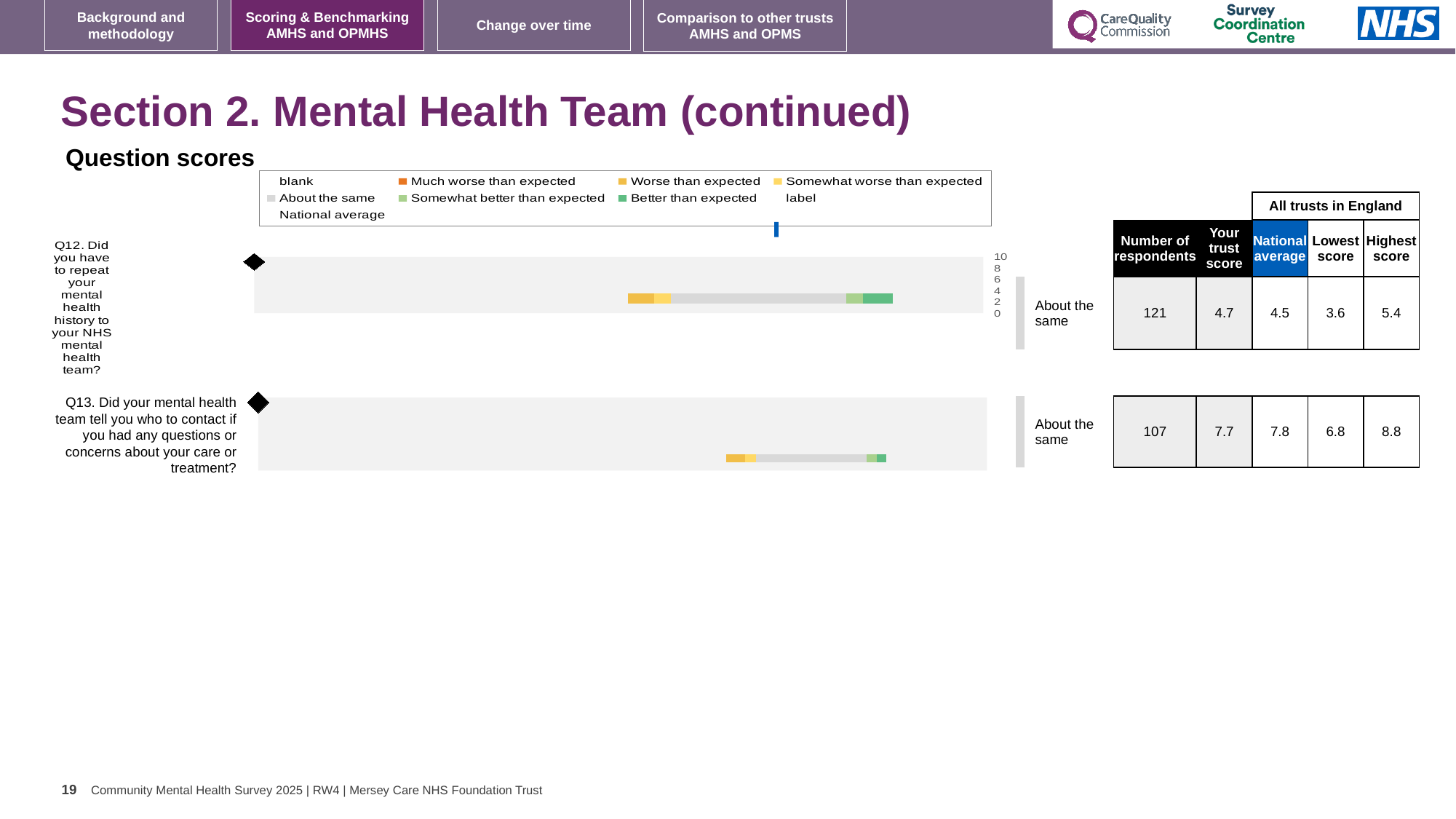
What is the 'Your trust score' value for Q13 (told who to contact with questions or concerns)? 7.7 What is the 'Your trust score' value for Q12 (repeating mental health history)? 4.7 How many respondents are recorded for Q12? 121 What benchmark category is shown next to the Q12 chart? About the same What is the lowest score among all trusts in England for Q12? 3.6 How many question charts are shown on this slide? 2 What is the highest score among all trusts in England for Q13? 8.8 For Q13, what is the difference between the highest score (8.8) and the lowest score (6.8) across all trusts in England? 2.0 What kind of chart is used to show the question scores? Bar chart For Q12, which is larger: the trust score or the national average? Your trust score (4.7) What is the national average score for Q12? 4.5 How many respondents are recorded for Q13? 107